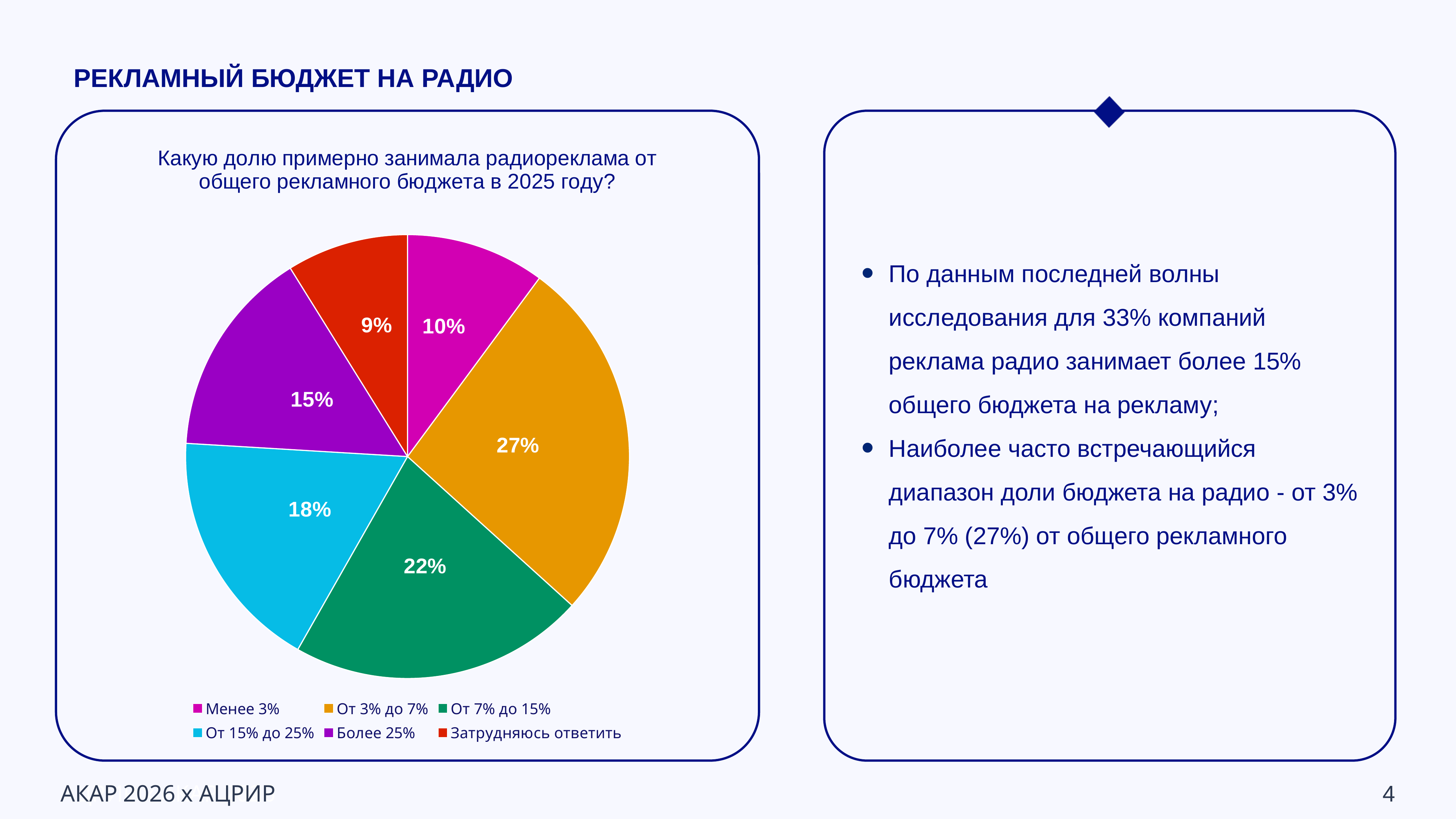
Which category has the largest slice of the pie? От 3% до 7% Which is larger: the slice for "От 15% до 25%" or the slice for "Более 25%"? От 15% до 25% What question is shown as the title of the pie chart? Какую долю примерно занимала радиореклама от общего рекламного бюджета в 2025 году? What is the value shown for the slice "Затрудняюсь ответить"? 9% What colour is the slice for "От 7% до 15%"? Green What is the difference between the values for "От 7% до 15%" and "Более 25%"? 7% What is the value shown for the slice "От 15% до 25%"? 18% What kind of chart is shown on the slide? Pie chart Which category has the smallest slice of the pie? Затрудняюсь ответить What share of the pie does the slice "От 3% до 7%" take? 27% What is the value shown for the slice "Менее 3%"? 10% How many slices does the pie chart have? 6